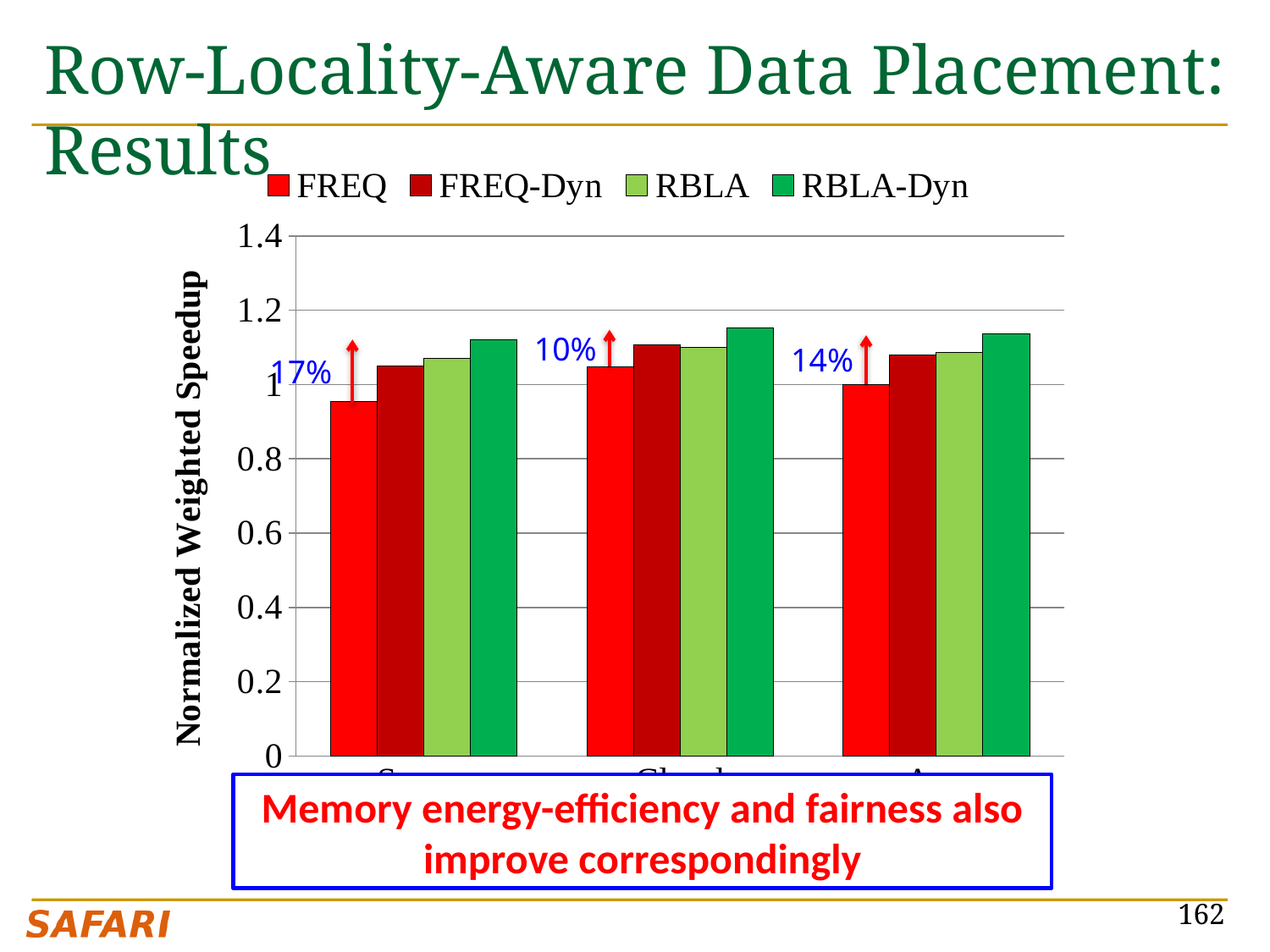
What percentage improvement is annotated above the rightmost group of bars? 14% What percentage improvement is annotated above the middle group of bars? 10% Is the RBLA-Dyn value in the middle group greater or less than 1.2? less Is the FREQ value in the leftmost group greater or less than 1? less In the rightmost group of bars, which is larger: FREQ or RBLA-Dyn? RBLA-Dyn How many groups of bars are plotted in the chart? 3 In the leftmost group of bars, which series has the highest value? RBLA-Dyn Which series is shown in bright red in the legend? FREQ What type of chart is shown on the slide? bar chart How many series does the legend list? 4 What is the label of the y-axis? Normalized Weighted Speedup What percentage improvement is annotated above the leftmost group of bars? 17%